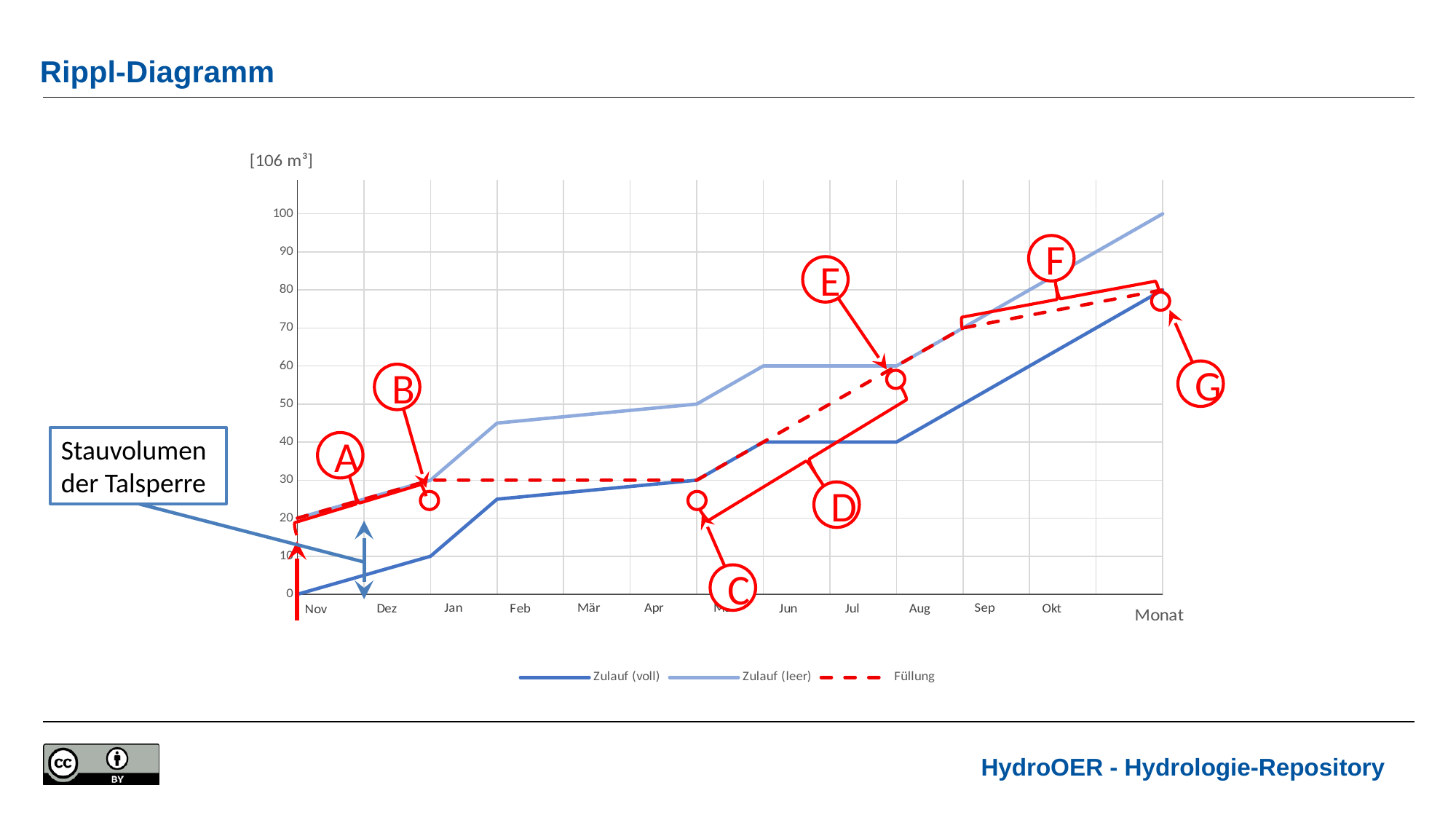
What unit is shown on the y axis of the chart? [106 m³] At what value does the Zulauf (leer) line start at the left edge of the chart? 20 Is the value of Zulauf (voll) at Okt greater or less than 50? greater At what value does the Zulauf (voll) line start at the left edge of the chart? 0 What value does the Zulauf (leer) line reach at the right end of the chart? 100 How many series does the legend list? 3 Does the Zulauf (leer) line rise or fall overall from Nov to Okt? rise Which series is higher at the right end of the chart, Zulauf (leer) or Zulauf (voll)? Zulauf (leer) How many month labels are shown along the x axis? 12 What type of chart is shown on the slide? line chart What are the three series named in the legend? Zulauf (voll), Zulauf (leer), Füllung Is the value of Zulauf (leer) at Feb greater or less than 40? greater